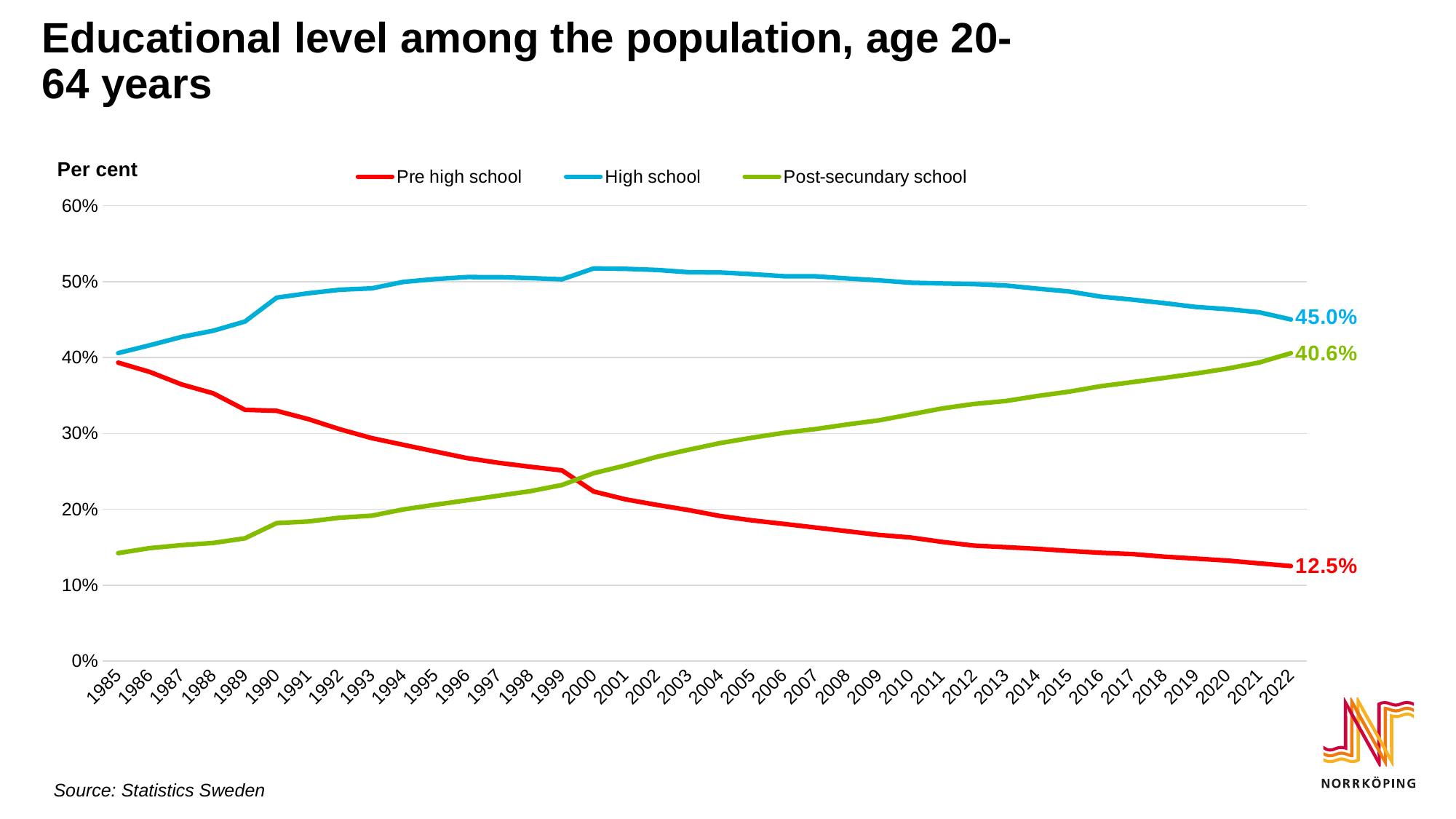
How many years are shown on the x axis? 38 Does the Pre high school series rise or fall from 1985 to 2022? Fall Is the value for Post-secundary school in 1985 greater or less than 20%? less What is the difference between the High school and Post-secundary school values in 2022? 4.4 percentage points What is the value for Pre high school in 2022? 12.5% What kind of chart is shown on the slide? Line chart Which series has the lowest value in 2022? Pre high school What is the value for Post-secundary school in 2022? 40.6% In 2022, which is larger: the High school value or the Post-secundary school value? High school What is the value for High school in 2022? 45.0% How many series does the legend list? 3 Is the value for Pre high school in 1985 greater or less than 30%? greater